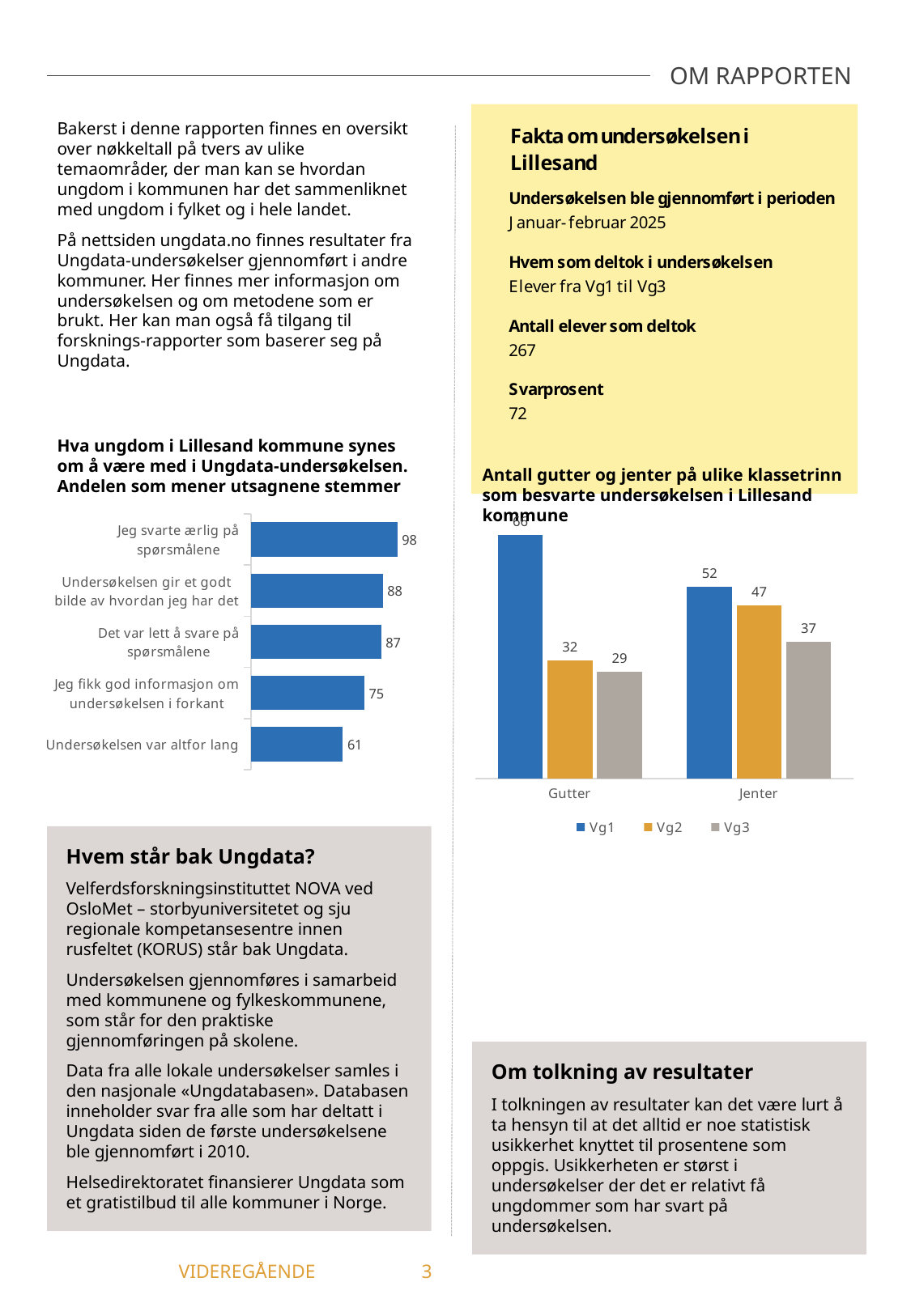
In the left chart on youth opinions about the Ungdata survey, which statement has the highest value? Jeg svarte ærlig på spørsmålene What type of chart is the left chart on youth opinions about the Ungdata survey? Bar chart In the left chart on youth opinions about the Ungdata survey, which statement has the lowest value? Undersøkelsen var altfor lang In the right chart on the number of boys and girls by grade, which is larger: Gutter Vg1 or Jenter Vg1? Gutter Vg1 In the right chart on the number of boys and girls by grade, what is the difference between Jenter Vg1 and Jenter Vg3? 15 How many statements are shown in the left chart on youth opinions about the Ungdata survey? 5 In the right chart on the number of boys and girls by grade, what is the value for Gutter in Vg3? 29 In the left chart on youth opinions about the Ungdata survey, what is the value for 'Undersøkelsen var altfor lang'? 61 In the right chart on the number of boys and girls by grade, how many Jenter in Vg2 answered the survey? 47 In the left chart on youth opinions about the Ungdata survey, what is the difference between 'Undersøkelsen gir et godt bilde av hvordan jeg har det' and 'Jeg fikk god informasjon om undersøkelsen i forkant'? 13 How many series does the legend list in the right chart on the number of boys and girls by grade? 3 In the left chart on youth opinions about the Ungdata survey, what percentage agreed with 'Jeg svarte ærlig på spørsmålene'? 98